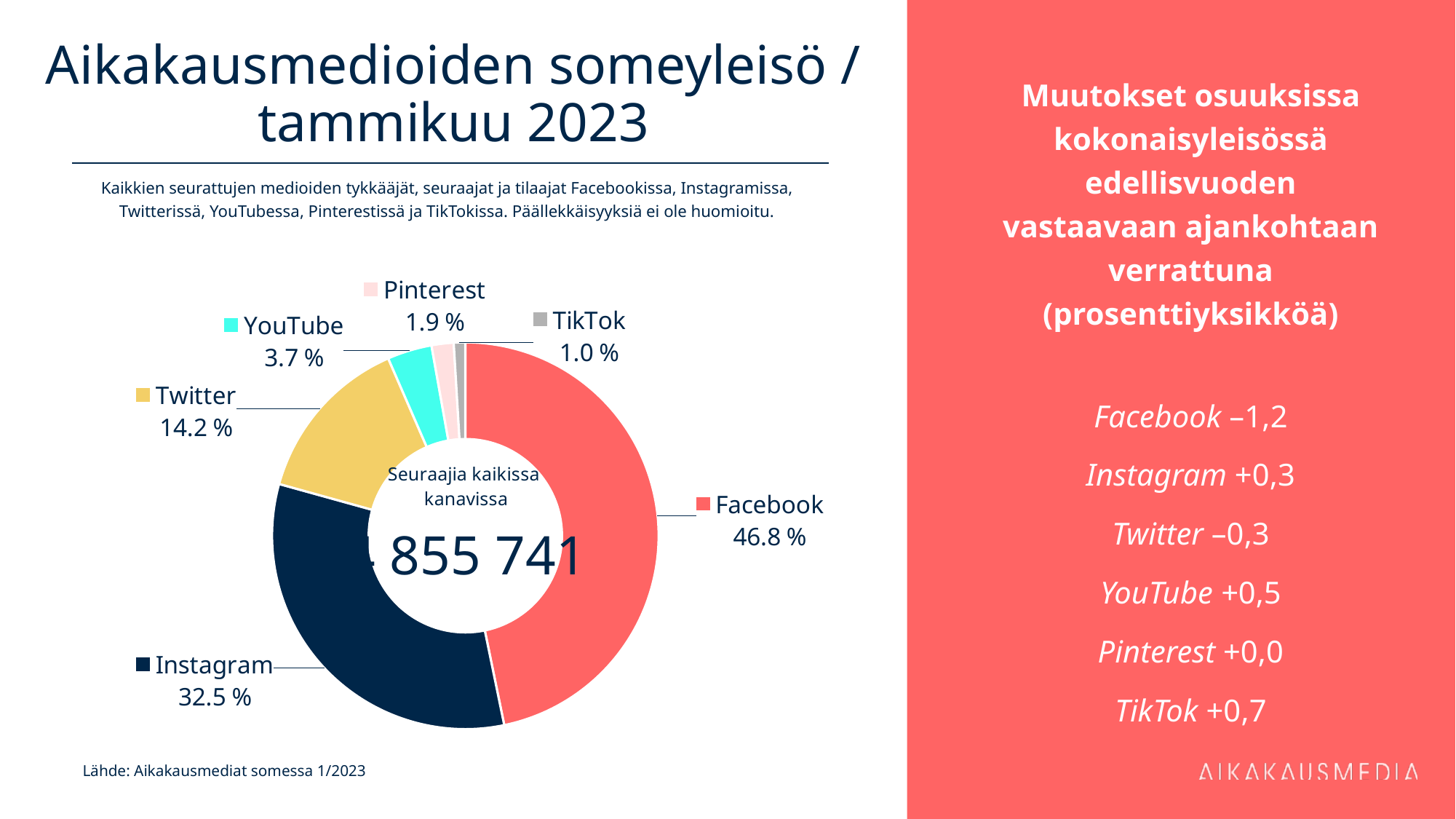
How many platforms are shown in the donut chart? 6 What share does YouTube hold in the donut chart? 3.7 % What share of the social media audience does Facebook hold in the donut chart? 46.8 % What share does TikTok hold in the donut chart? 1.0 % What share does Instagram hold in the donut chart? 32.5 % What share does Twitter hold in the donut chart? 14.2 % Which has a larger share, Twitter or YouTube? Twitter Which platform has the largest share in the donut chart? Facebook What type of chart is used on the slide? Donut (pie) chart Which platform has the smallest share in the donut chart? TikTok What colour is the Twitter slice in the donut chart? Yellow What is the difference in percentage points between Facebook's and Instagram's shares? 14.3